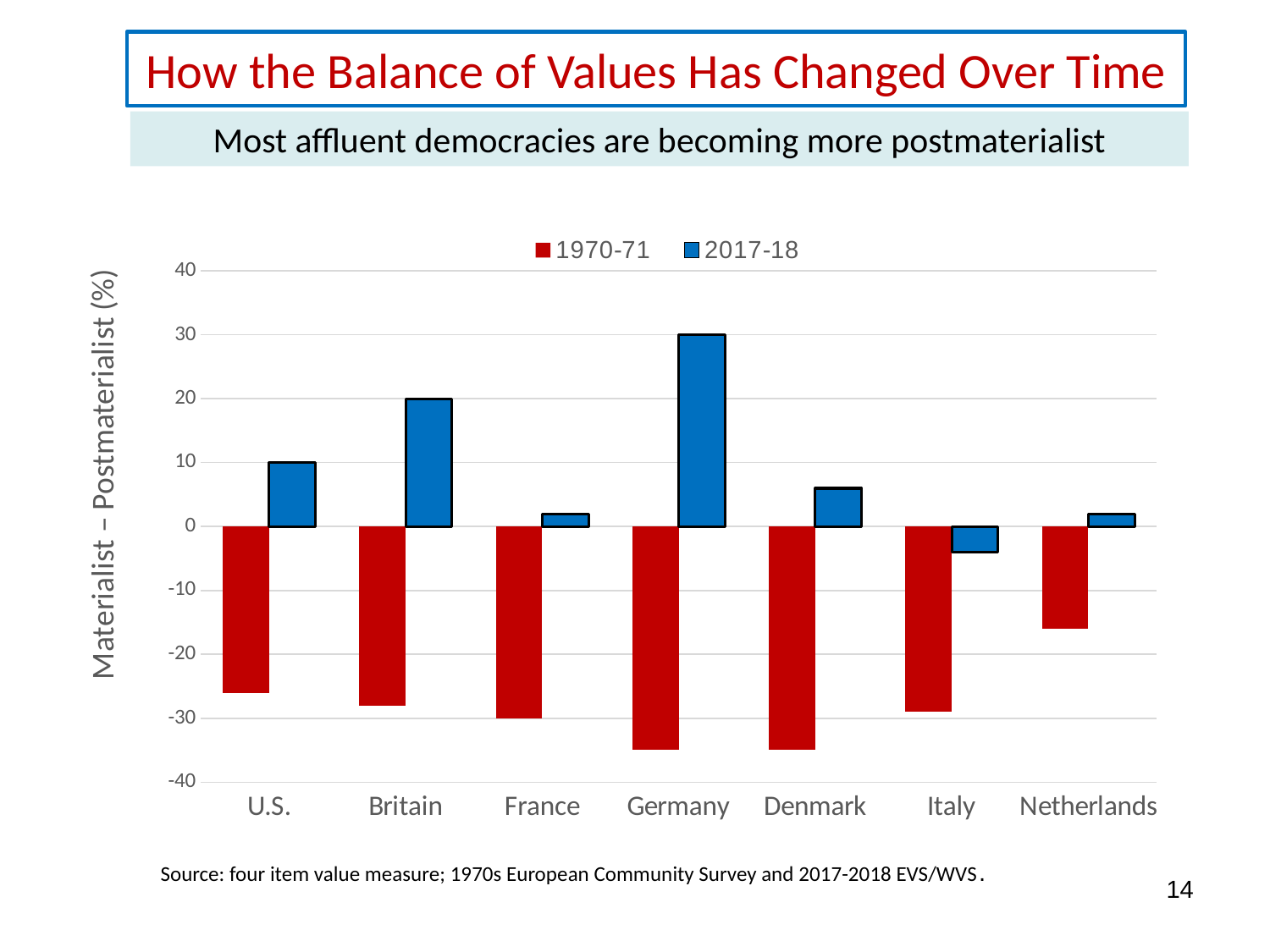
Which country has the lowest 2017-18 value? Italy Which is larger, the 2017-18 value for Denmark or the 2017-18 value for France? Denmark Is the 1970-71 value for Denmark greater or less than -30? less What is the 2017-18 value for the U.S.? 10 Which country has the highest 2017-18 value? Germany What is the 2017-18 value for Germany? 30 Is the 1970-71 value for the Netherlands greater or less than -20? greater What is the 1970-71 value for France? -30 Which country has the highest (least negative) 1970-71 value? Netherlands What is the 2017-18 value for Britain? 20 How many series does the legend list? 2 How many countries are shown on the x axis? 7